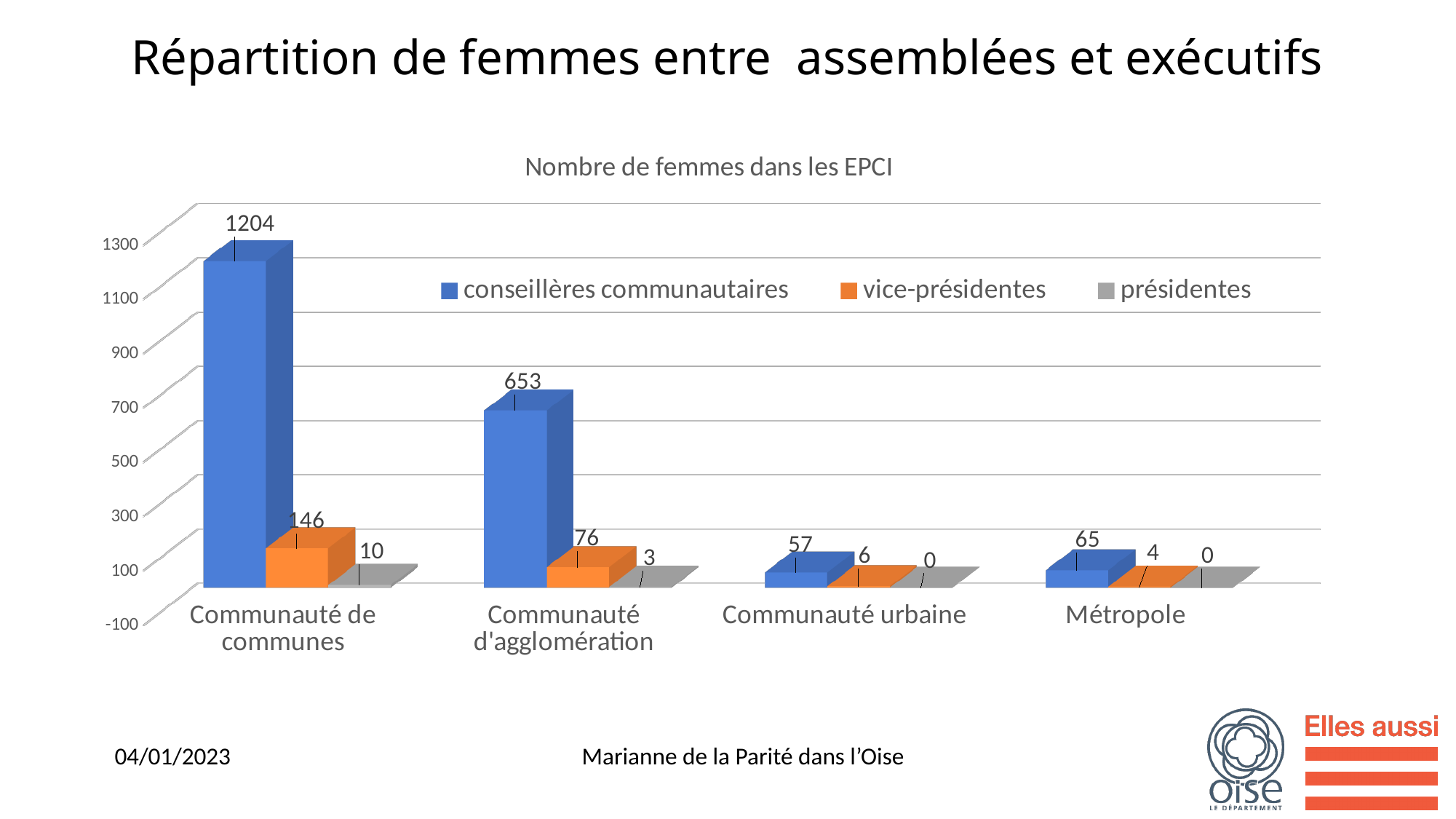
What is the number of conseillères communautaires for Métropole? 65 Which is larger: the vice-présidentes value for Communauté de communes or for Communauté d'agglomération? Communauté de communes What is the title of the chart? Nombre de femmes dans les EPCI What kind of chart is shown? bar chart How many series does the legend list? 3 What is the number of vice-présidentes for Communauté d'agglomération? 76 What is the number of conseillères communautaires for Communauté de communes? 1204 How many categories are shown on the x axis? 4 What is the difference between the conseillères communautaires values for Communauté de communes and Communauté d'agglomération? 551 Which category has the lowest number of vice-présidentes? Métropole Which category has the highest number of conseillères communautaires? Communauté de communes What is the number of présidentes for Communauté urbaine? 0